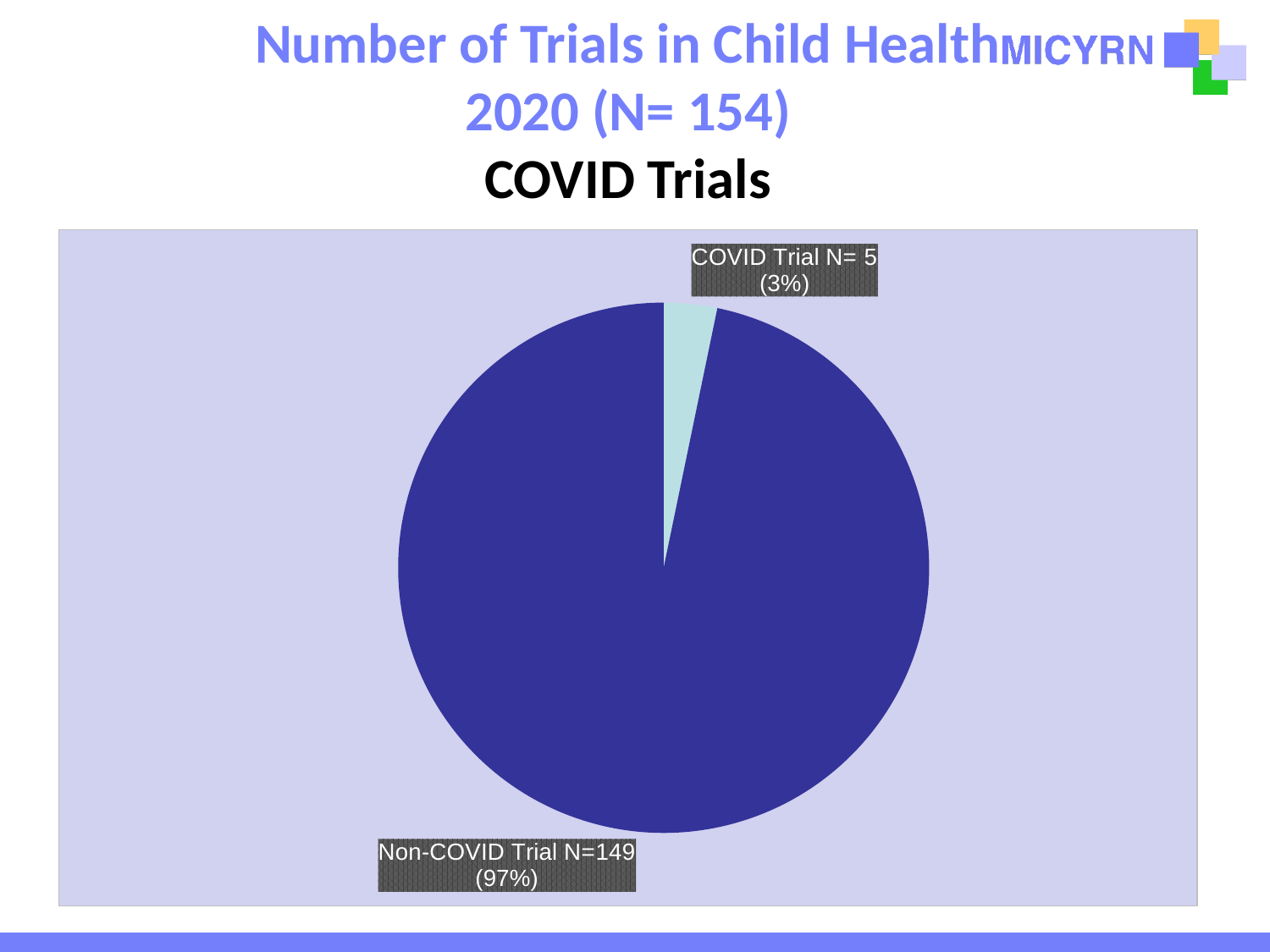
How many slices does the pie chart have? 2 What percentage of trials are Non-COVID trials? 97% Which is larger, the number of COVID trials or Non-COVID trials? Non-COVID trials Which slice is the smallest in the pie chart? COVID Trial What kind of chart is shown on the slide? pie chart Which slice is the largest in the pie chart? Non-COVID Trial How many COVID trials are shown in the pie chart? 5 How many Non-COVID trials are shown in the pie chart? 149 What is the total number of trials shown in the chart? 154 What is the title of the chart? COVID Trials What percentage of trials are COVID trials? 3% What is the difference between the number of Non-COVID trials and COVID trials? 144